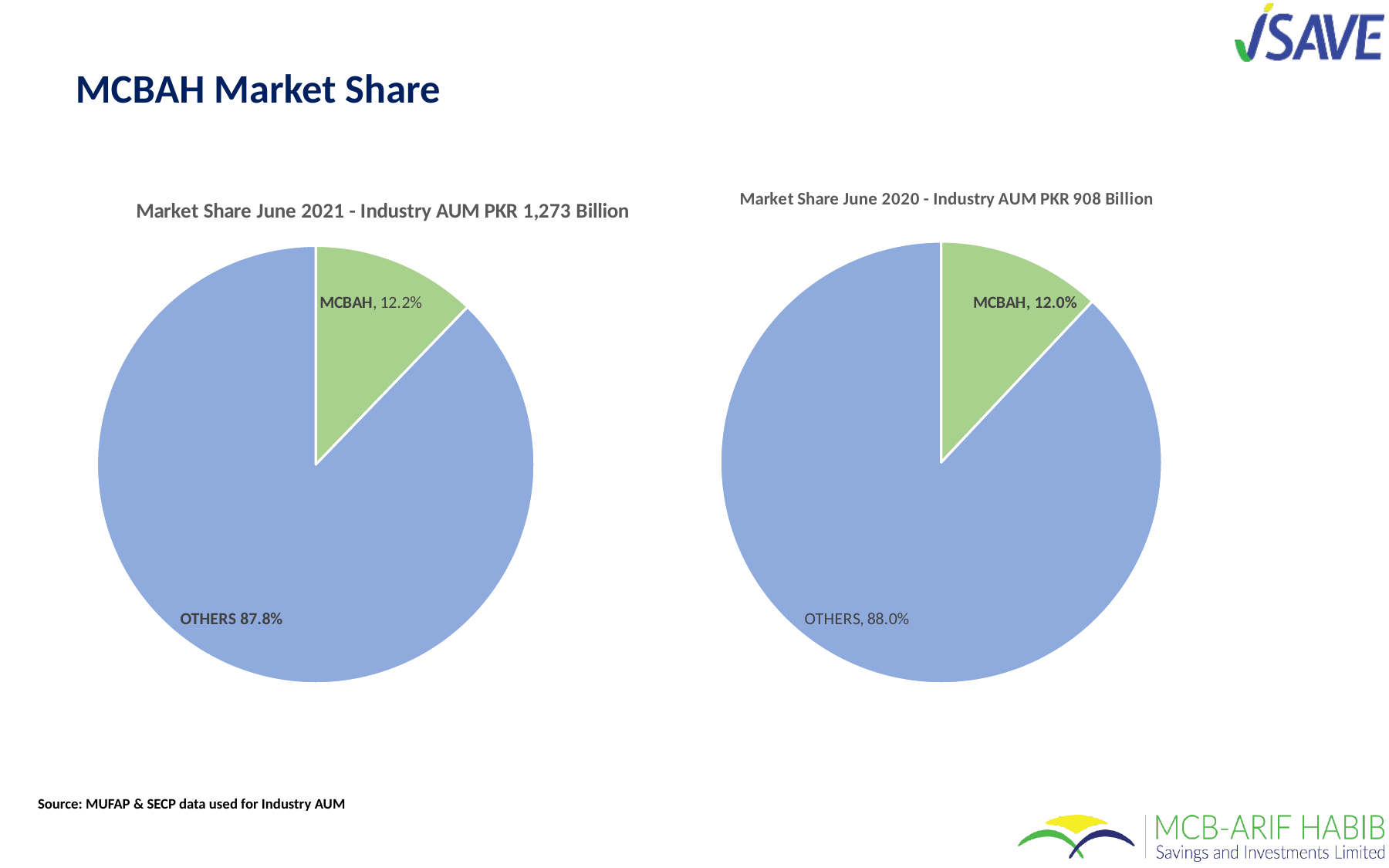
In the 'Market Share June 2020' chart, what share does OTHERS hold? 88.0% What industry AUM figure is given in the title of the 'Market Share June 2021' chart? PKR 1,273 Billion What kind of chart is the 'Market Share June 2021' chart? Pie chart How many slices does the 'Market Share June 2020' pie chart have? 2 In the 'Market Share June 2021' chart, what share does MCBAH hold? 12.2% In the 'Market Share June 2020' chart, which slice is the largest? OTHERS In the 'Market Share June 2021' chart, which slice is the smallest? MCBAH In the 'Market Share June 2020' chart, what share does MCBAH hold? 12.0% Is MCBAH's share larger in the June 2021 chart or the June 2020 chart? June 2021 In the 'Market Share June 2021' chart, what share does OTHERS hold? 87.8% What colour is the MCBAH slice in the 'Market Share June 2020' chart? Green In the 'Market Share June 2021' chart, what is the difference between the OTHERS share and the MCBAH share? 75.6%